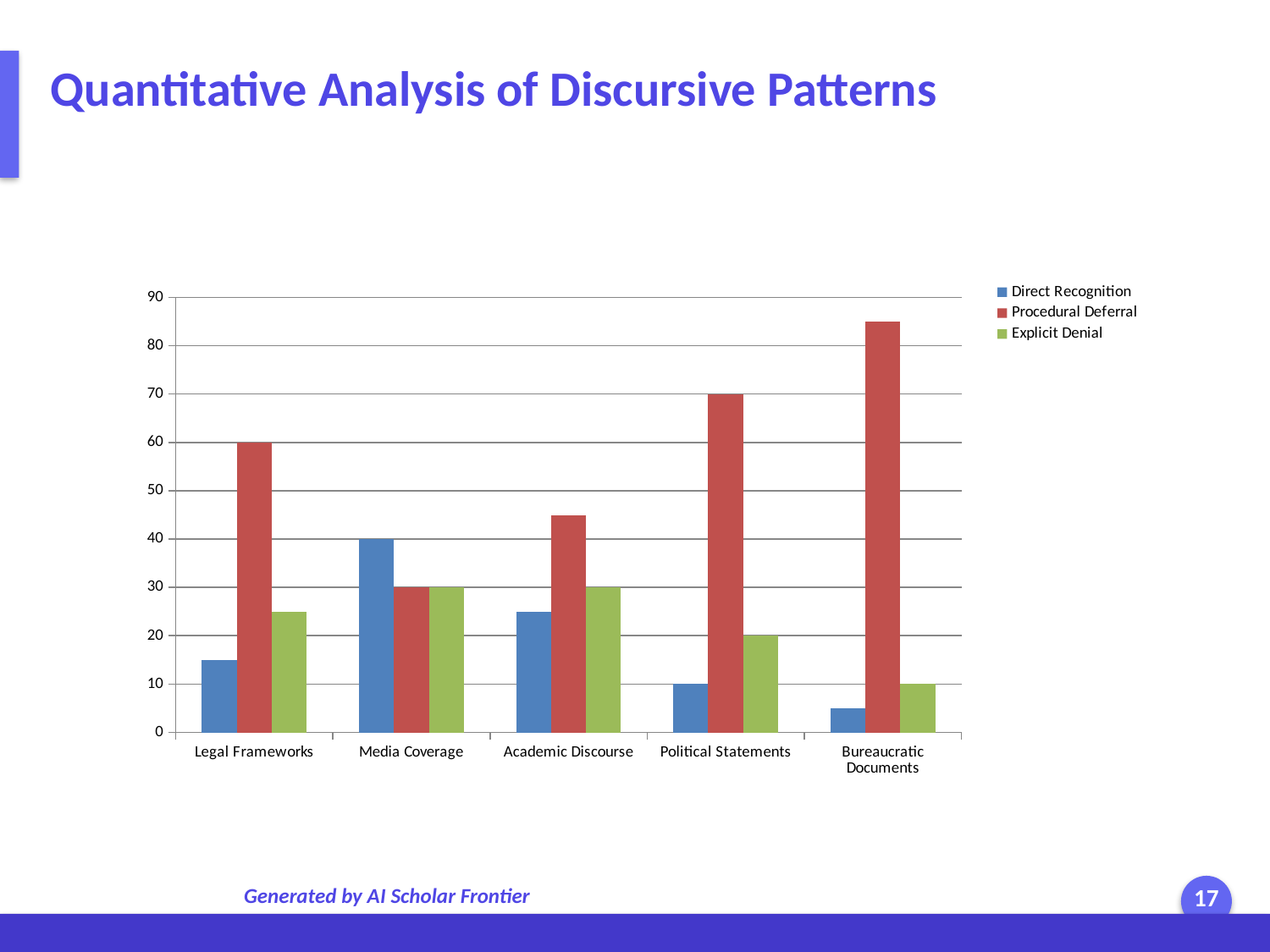
For Academic Discourse, which is larger: Procedural Deferral or Explicit Denial? Procedural Deferral What is the Procedural Deferral value for Political Statements? 70 Is the Procedural Deferral value for Bureaucratic Documents greater or less than 80? greater Which category has the highest Procedural Deferral value? Bureaucratic Documents How many categories are shown on the x axis? 5 What is the Procedural Deferral value for Legal Frameworks? 60 What is the Explicit Denial value for Bureaucratic Documents? 10 Which category has the lowest Direct Recognition value? Bureaucratic Documents How many series does the legend list? 3 What is the difference between the Procedural Deferral and Direct Recognition values for Political Statements? 60 What type of chart is shown on the slide? bar chart What is the Direct Recognition value for Media Coverage? 40